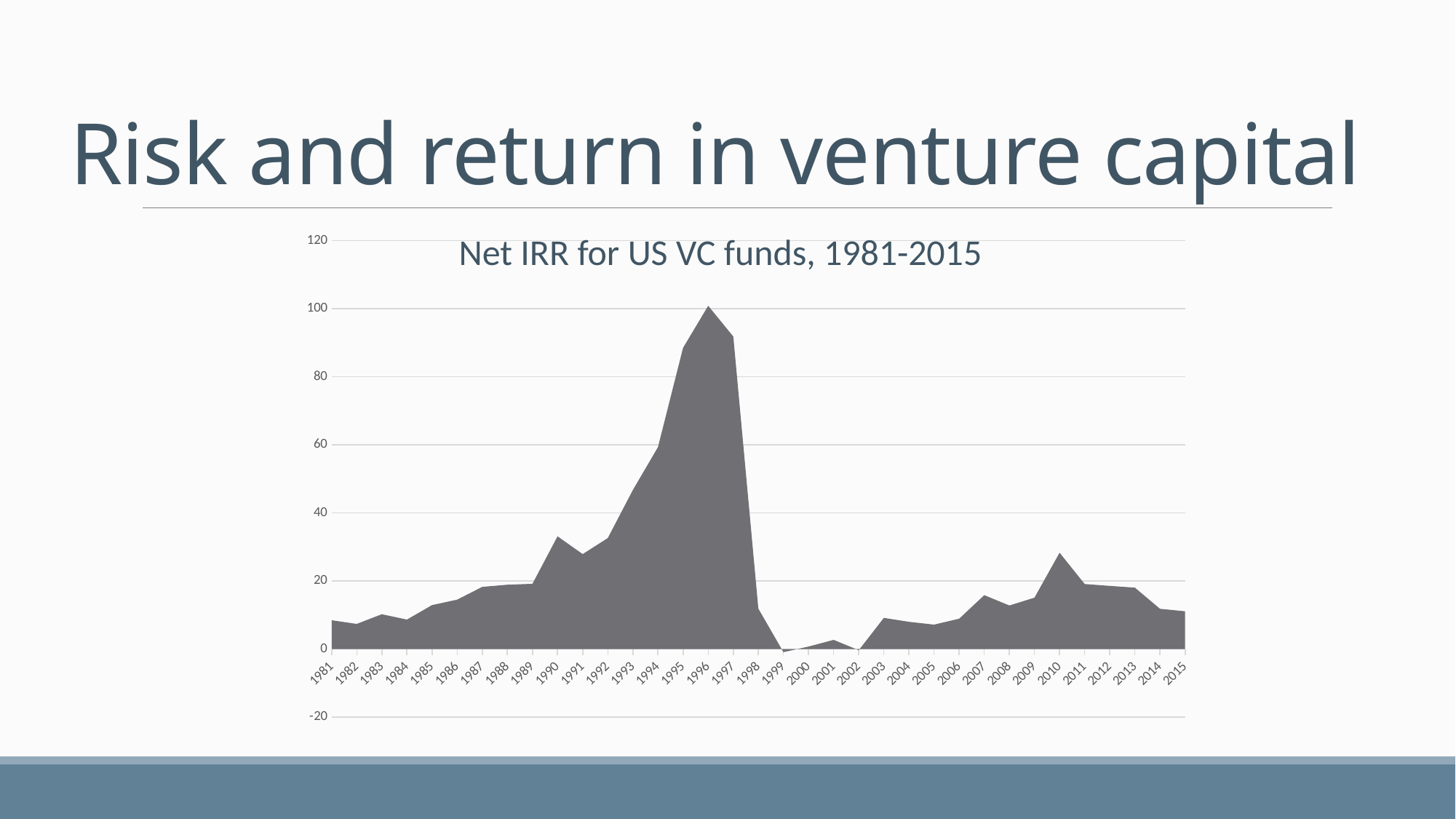
In which year does the net IRR reach its highest value? 1996 What kind of chart is shown on the slide? Area chart What is the title of the chart? Net IRR for US VC funds, 1981-2015 Is the value for 1990 greater or less than 20? greater Which year has the larger net IRR, 1996 or 2010? 1996 Do the values rise or fall from 1996 to 1999? Fall Do the values rise or fall from 1992 to 1996? Rise Is the value for 2010 greater or less than 20? greater Is the value for 1994 greater or less than 40? greater How many years are plotted along the x axis of the chart? 35